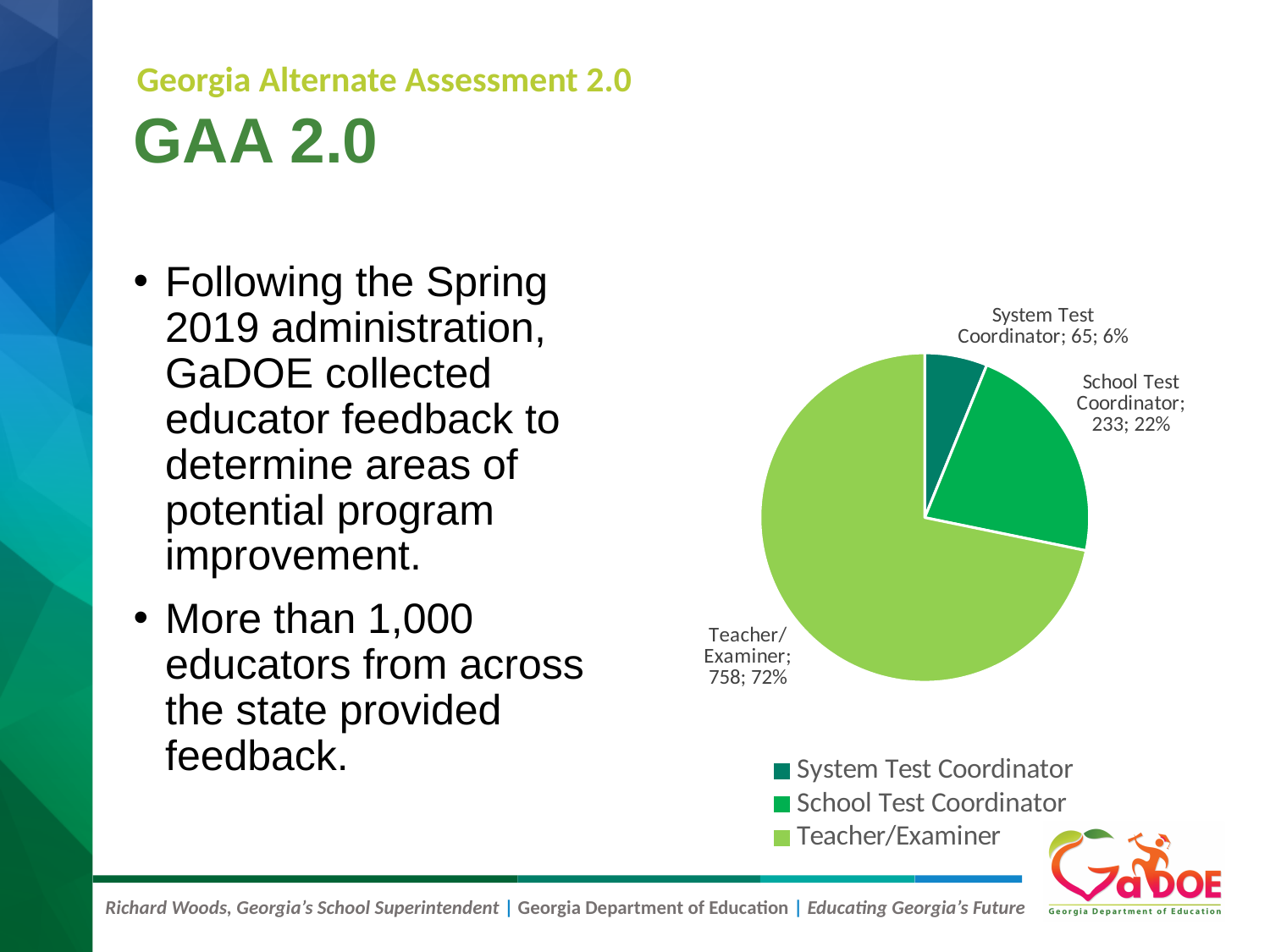
What is the value for Teacher/Examiner? 758 What share of the pie does School Test Coordinator represent? 22% What share of the pie does Teacher/Examiner represent? 72% Which is larger, the value for School Test Coordinator or System Test Coordinator? School Test Coordinator What is the value for School Test Coordinator? 233 What is the value for System Test Coordinator? 65 What kind of chart is shown on the slide? pie chart What is the difference between the values for Teacher/Examiner and School Test Coordinator? 525 Which category has the smallest slice? System Test Coordinator How many entries does the legend list? 3 Which category has the largest slice? Teacher/Examiner How many slices does the pie chart have? 3